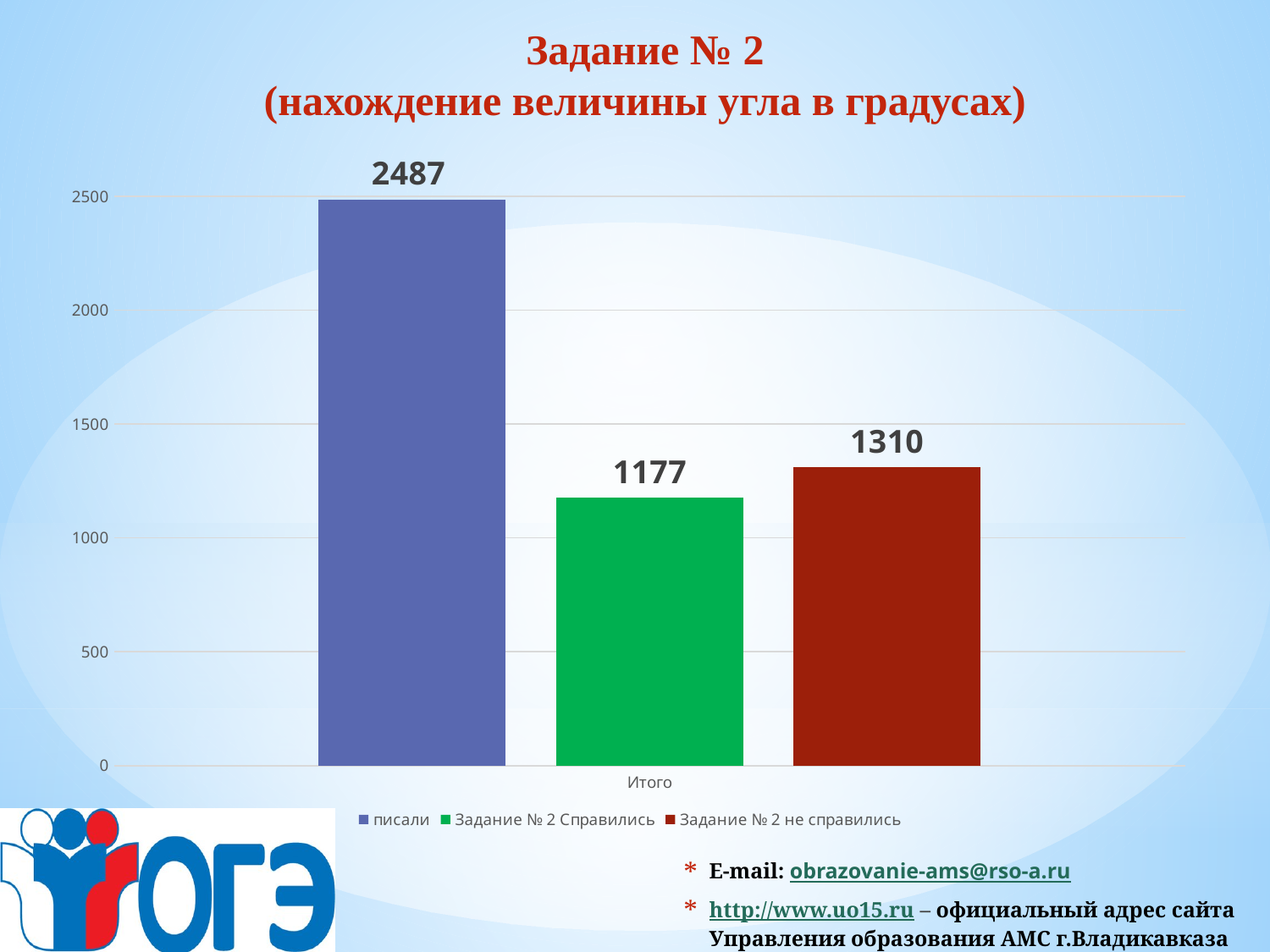
What is the difference between the values for "писали" and "Задание № 2 не справились"? 1177 What is the value for the series "писали"? 2487 What kind of chart is shown on the slide? bar chart Is the value for "Задание № 2 Справились" greater or less than 1500? less What is the value for the series "Задание № 2 Справились"? 1177 What is the category label on the x axis? Итого How many series does the legend list? 3 Which series has the lowest value? Задание № 2 Справились Which is larger: the value for "Задание № 2 Справились" or "Задание № 2 не справились"? Задание № 2 не справились Which series has the highest value? писали What is the difference between the values for "Задание № 2 не справились" and "Задание № 2 Справились"? 133 What is the value for the series "Задание № 2 не справились"? 1310